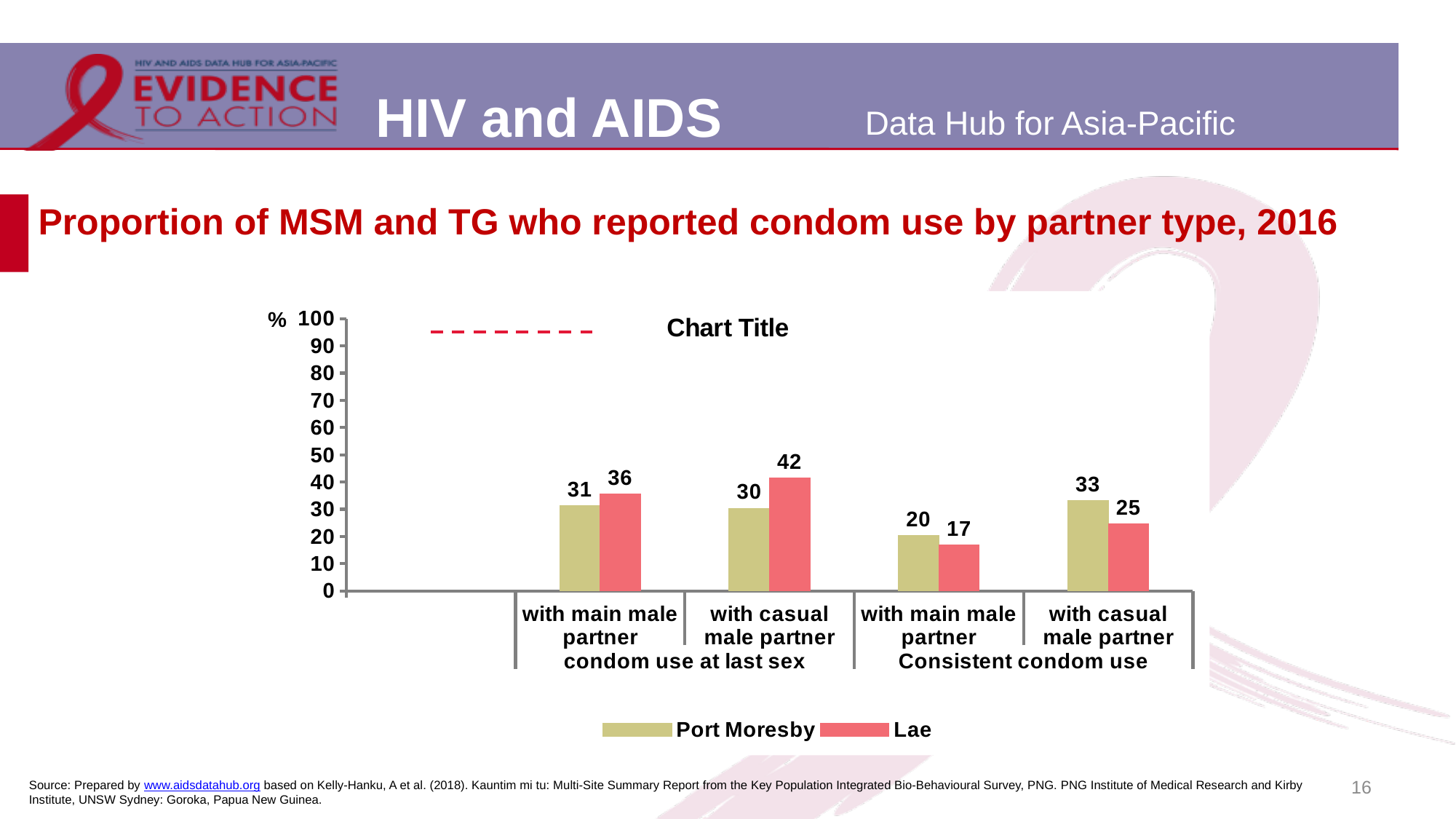
What is the difference between Lae and Port Moresby for condom use at last sex with casual male partner? 12 What is the value for Port Moresby for consistent condom use with casual male partner? 33 Which category has the highest value for Lae? Condom use at last sex with casual male partner Which category has the lowest value for Port Moresby? Consistent condom use with main male partner How many series does the legend list? 2 What is the value for Port Moresby for condom use at last sex with main male partner? 31 What colour are the bars for Lae? Red What is the value for Lae for condom use at last sex with casual male partner? 42 What kind of chart is shown on the slide? Bar chart For consistent condom use with main male partner, which is larger, Port Moresby or Lae? Port Moresby Is the value for Lae for condom use at last sex with main male partner greater or less than 30? greater What is the value for Lae for consistent condom use with main male partner? 17